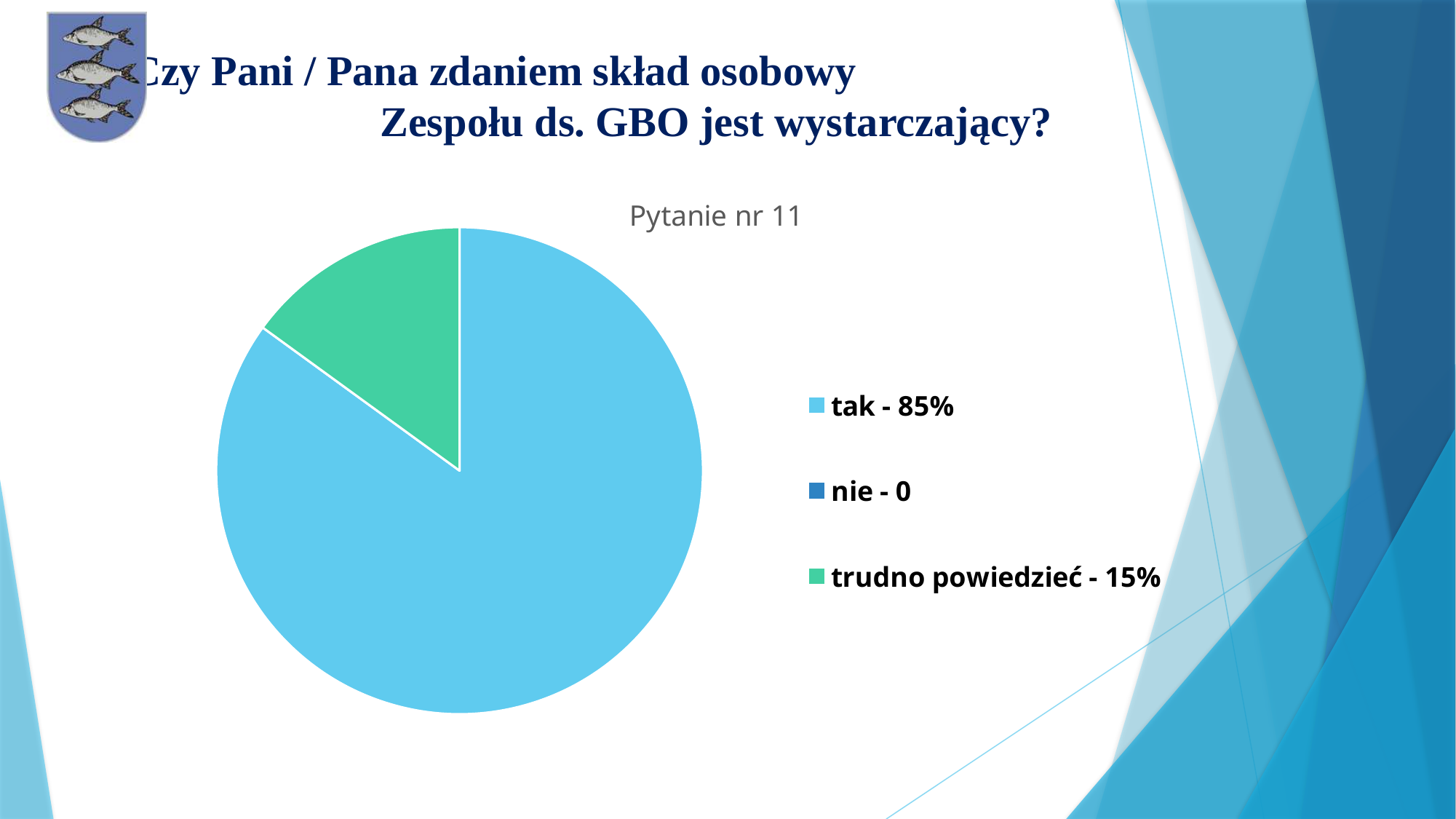
What is the chart's title? Pytanie nr 11 Which category has the smallest value in the legend? nie How many categories does the legend list? 3 What share of the pie does "tak" have? 85% What colour is the "trudno powiedzieć" slice? green What is the difference between the shares for "tak" and "trudno powiedzieć"? 70% Which category has the largest share of the pie? tak What share of the pie does "trudno powiedzieć" have? 15% Is the share for "tak" greater or less than 50%? greater What value is shown for "nie" in the legend? 0 What kind of chart is shown on the slide? pie chart Which is larger, the share for "tak" or the share for "trudno powiedzieć"? tak